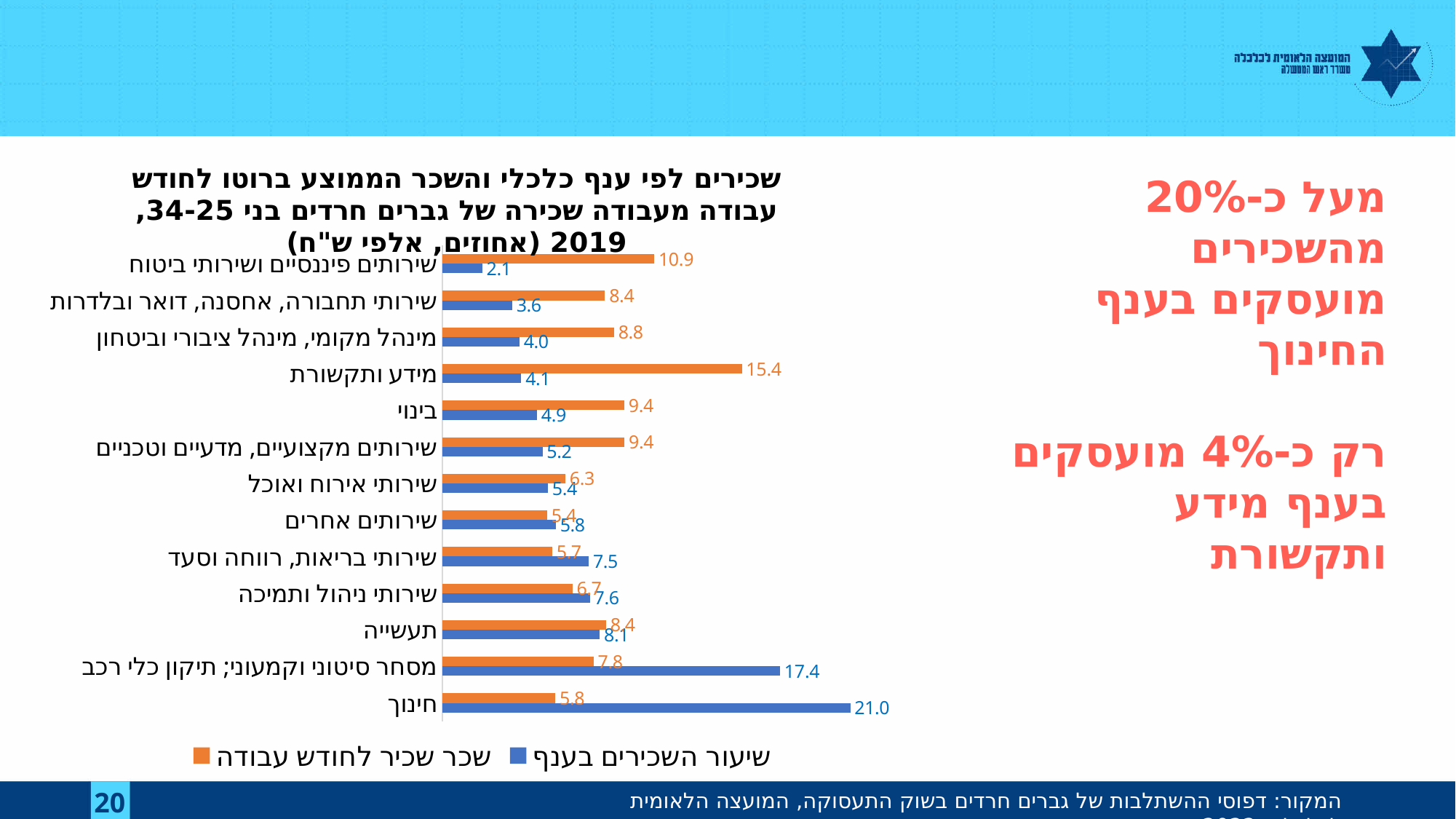
How many series does the legend list? 2 Which category has the lowest value for שיעור השכירים בענף? שירותים פיננסיים ושירותי ביטוח Which colour represents שיעור השכירים בענף in the chart? Blue What is the difference between the שיעור השכירים בענף values for חינוך and מסחר סיטוני וקמעוני; תיקון כלי רכב? 3.6 What is the value of שיעור השכירים בענף for מסחר סיטוני וקמעוני; תיקון כלי רכב? 17.4 Which category has the highest value for שכר שכיר לחודש עבודה? מידע ותקשורת How many categories are shown in the chart? 13 Which category has the highest value for שיעור השכירים בענף? חינוך What is the value of שכר שכיר לחודש עבודה for מידע ותקשורת? 15.4 What kind of chart is shown on the slide? Bar chart What is the value of שיעור השכירים בענף for חינוך? 21.0 Which is larger for בינוי: שכר שכיר לחודש עבודה or שיעור השכירים בענף? שכר שכיר לחודש עבודה